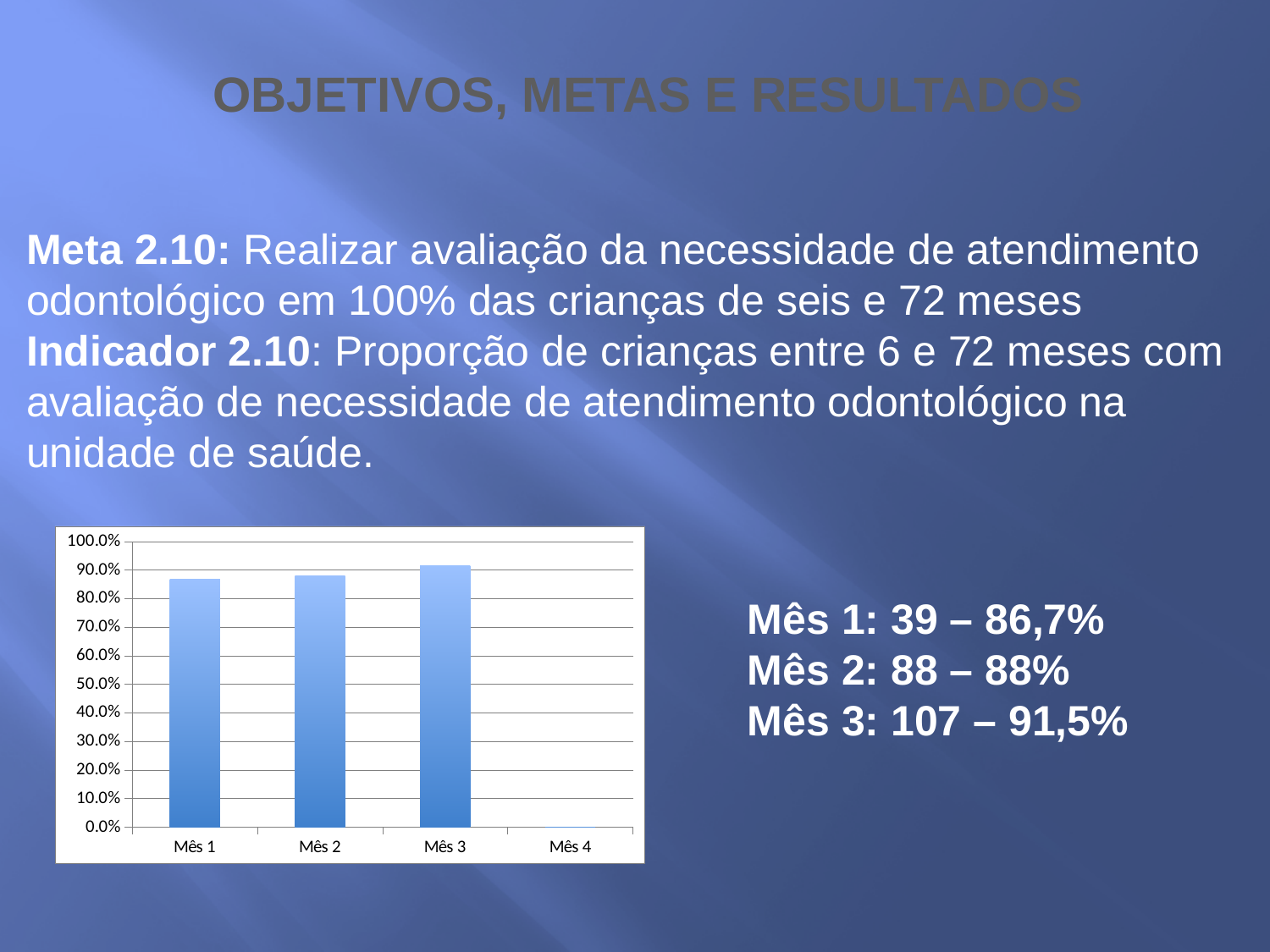
Is the value for Mês 1 greater or less than 80.0%? greater Do the bar values rise or fall from Mês 1 to Mês 3? rise According to the slide, what is the percentage for Mês 1? 86,7% How many bars are actually plotted in the chart? 3 According to the slide, what is the percentage for Mês 2? 88% Is the value for Mês 2 greater or less than 90.0%? less Which is larger, the value for Mês 3 or the value for Mês 1? Mês 3 According to the slide, what is the percentage for Mês 3? 91,5% Which month has the highest bar in the chart? Mês 3 How many categories are shown on the x axis of the chart? 4 Which category on the x axis has no bar plotted? Mês 4 What kind of chart is shown on the slide? bar chart